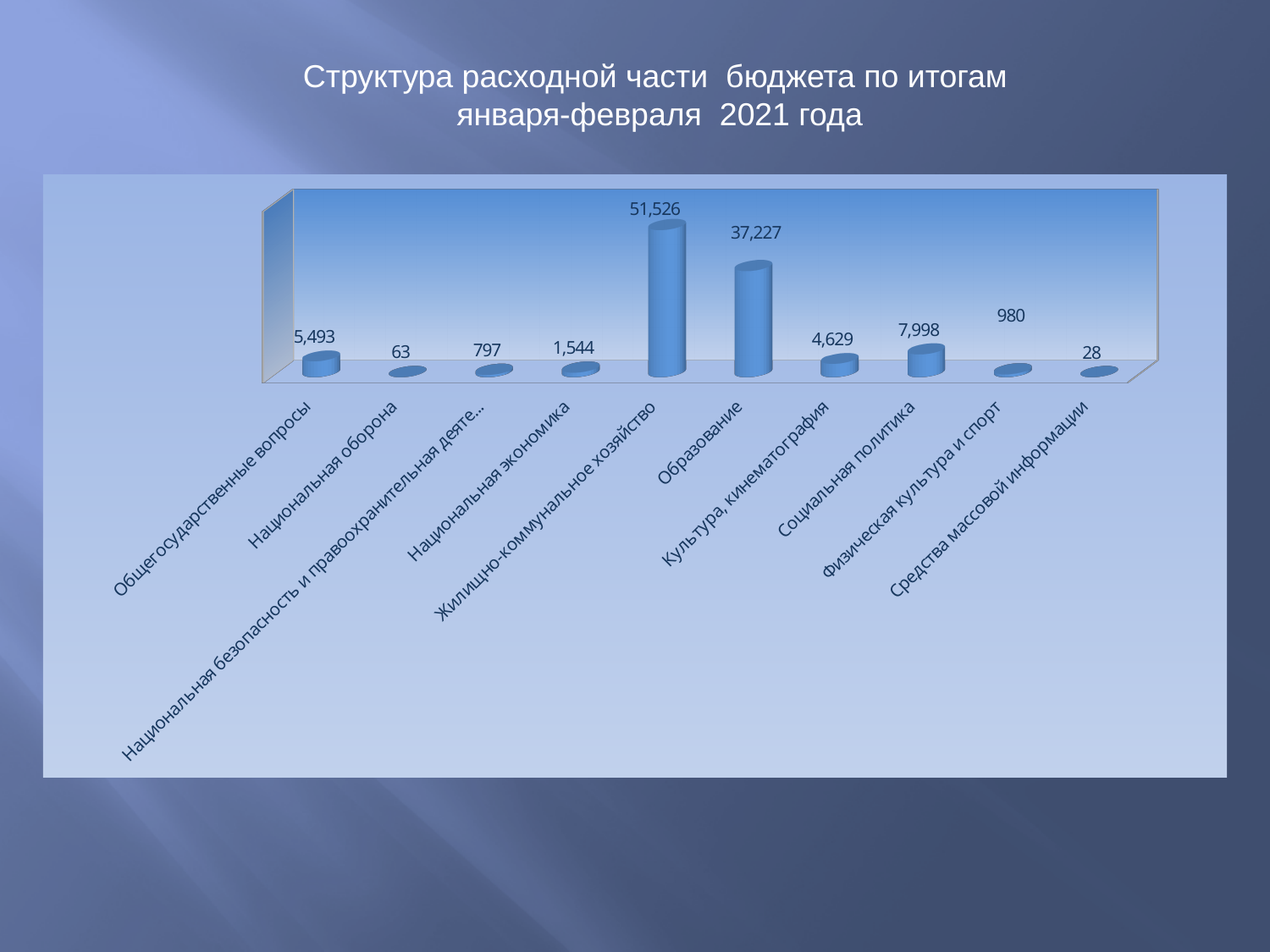
What is the value for Социальная политика? 7,998 Which is larger, the value for Общегосударственные вопросы or the value for Культура, кинематография? Общегосударственные вопросы What is the value for Образование? 37,227 What kind of chart is shown on the slide? Bar chart Which category has the lowest value? Средства массовой информации How many categories are shown in the chart? 10 What is the title of the slide? Структура расходной части бюджета по итогам января-февраля 2021 года What is the difference between the values for Жилищно-коммунальное хозяйство and Образование? 14,299 What is the value for Жилищно-коммунальное хозяйство? 51,526 Which category has the highest value? Жилищно-коммунальное хозяйство What is the value for Средства массовой информации? 28 What is the value for Национальная оборона? 63